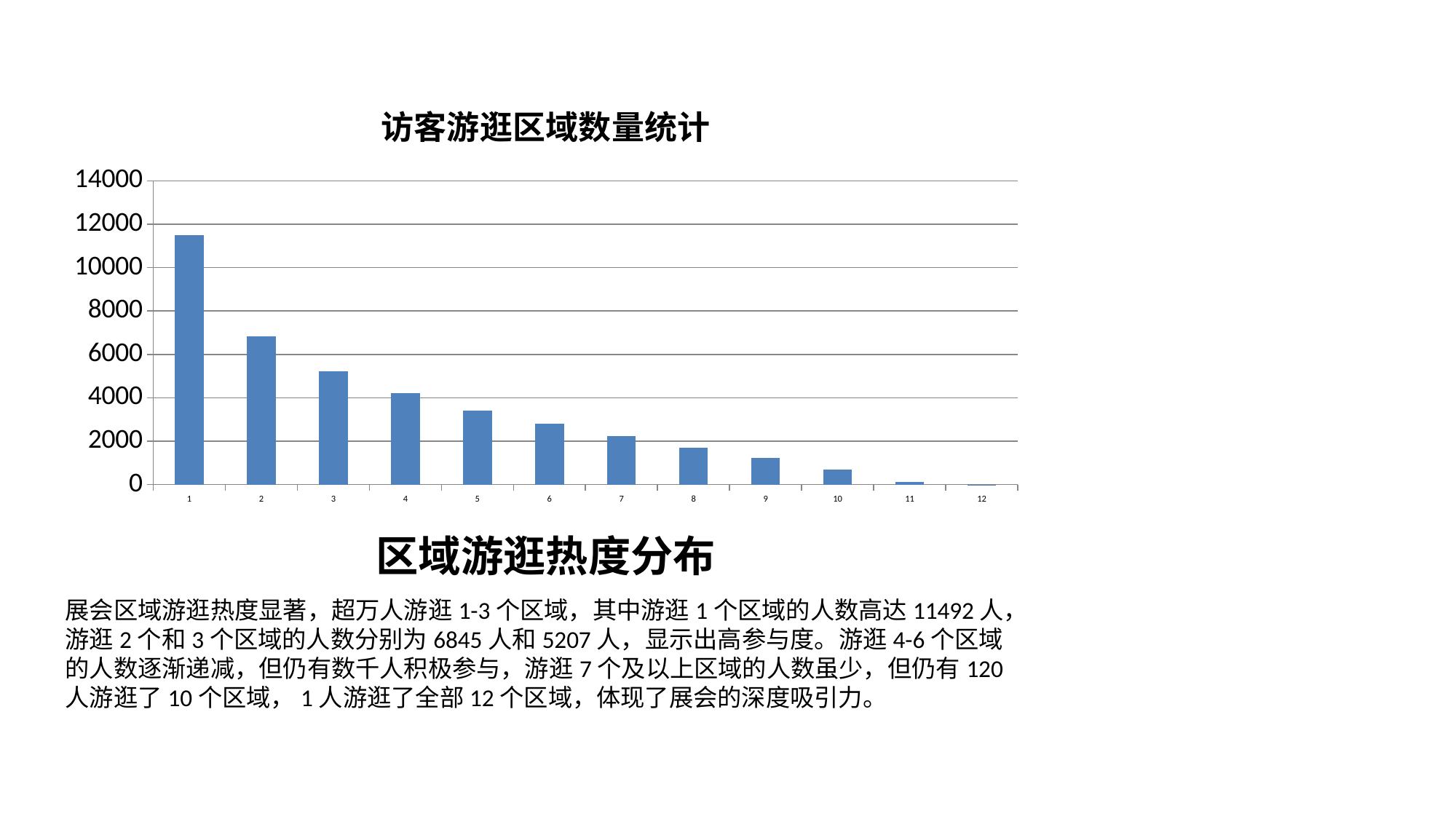
Which is larger, the value for category 5 or the value for category 7? category 5 How many categories are shown on the x axis of the chart? 12 According to the slide, how many visitors toured 2 areas (category 2)? 6845 人 Do the values rise or fall as you move from category 1 to category 12 along the x axis? fall What kind of chart is shown on the slide? bar chart Which category has the lowest bar in the chart? 12 According to the slide, how many visitors toured 1 area (category 1)? 11492 人 What is the title of the chart? 访客游逛区域数量统计 Is the value for category 8 greater or less than 2000? less Which category has the highest bar in the chart? 1 According to the slide, how many visitors toured 3 areas (category 3)? 5207 人 Is the value for category 4 greater or less than 4000? greater